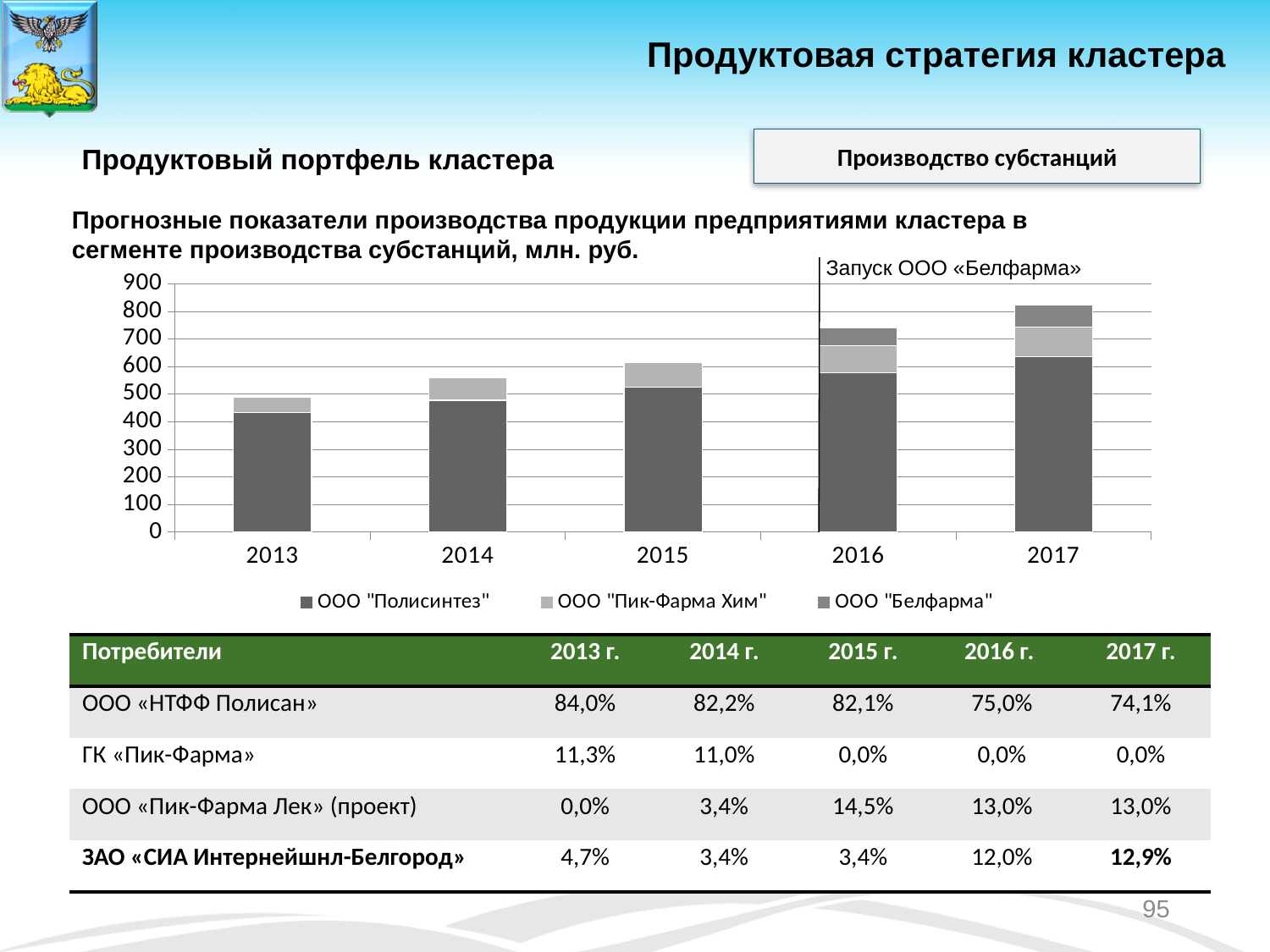
Is the total bar for 2016 greater or less than 700? greater According to the annotation on the chart, in which year is ООО «Белфарма» launched? 2016 Is the total bar for 2017 greater or less than 800? greater How many years are shown on the x axis of the chart? 5 Is the total bar for 2013 greater or less than 600? less Which year has the highest total bar in the chart? 2017 How many series does the chart legend list? 3 Which series is listed first in the chart legend? ООО "Полисинтез" Do the total bar heights rise or fall from 2013 to 2017? rise Which year has the lowest total bar in the chart? 2013 What kind of chart is shown on the slide? stacked bar chart